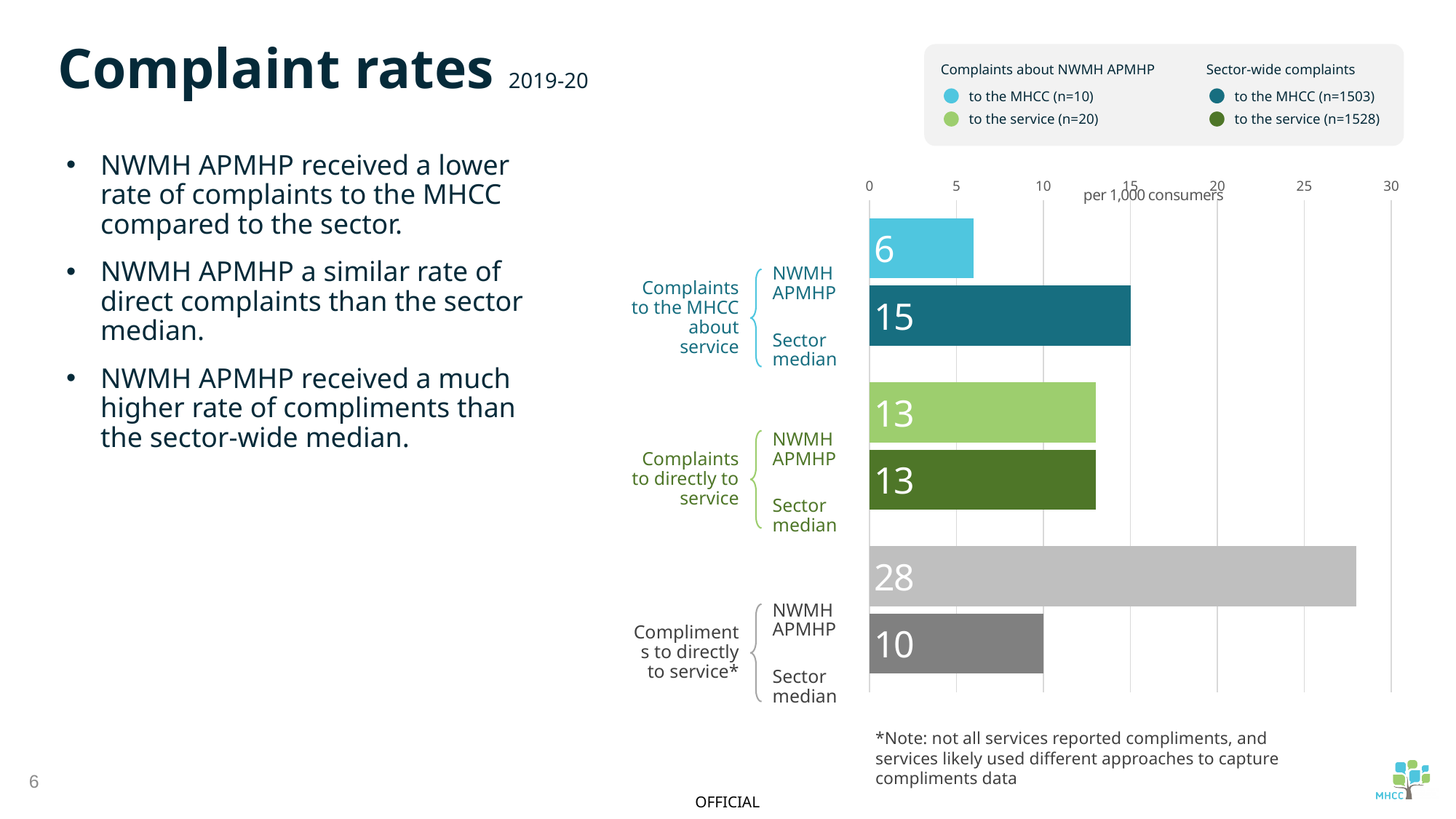
Which bar in the chart has the lowest value? Complaints to the MHCC about service, NWMH APMHP What is the NWMH APMHP rate of complaints made directly to service, per 1,000 consumers? 13 What is the difference between the sector median and NWMH APMHP rates of complaints to the MHCC about service? 9 Which is larger: the NWMH APMHP rate of compliments to directly to service or the sector median rate? NWMH APMHP What type of chart is shown on the slide? Bar chart Which bar in the chart has the highest value? Compliments to directly to service, NWMH APMHP What is the sector median rate of complaints to the MHCC about service, per 1,000 consumers? 15 What is the rate of complaints to the MHCC about service for NWMH APMHP, per 1,000 consumers? 6 What is the difference between the NWMH APMHP and sector median rates of compliments to directly to service? 18 What is the NWMH APMHP rate of compliments made directly to service, per 1,000 consumers? 28 What is the sector median rate of compliments made directly to service, per 1,000 consumers? 10 How many bars are plotted in the chart? 6